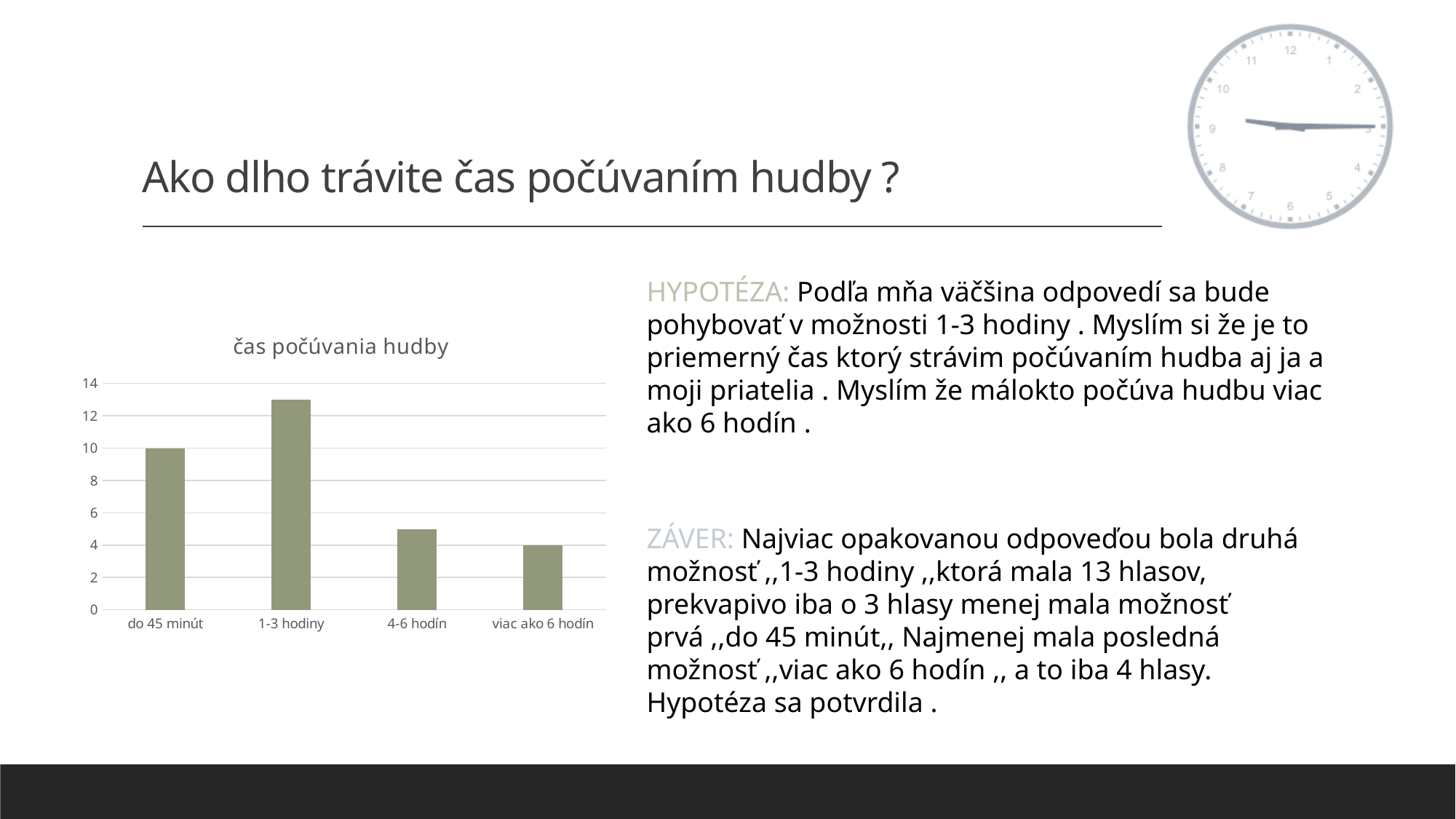
What is the highest value shown on the vertical axis of the chart? 14 Which category has the highest value? 1-3 hodiny What is the value for 'do 45 minút'? 10 What kind of chart is shown on the slide? bar chart Is the value for '4-6 hodín' greater or less than 6? less Which is larger, the value for 'do 45 minút' or the value for '4-6 hodín'? do 45 minút Is the value for '1-3 hodiny' greater or less than 12? greater What is the difference between the value for 'do 45 minút' and the value for 'viac ako 6 hodín'? 6 Which category has the lowest value? viac ako 6 hodín How many categories are shown on the x axis of the chart? 4 What is the title of the chart? čas počúvania hudby What is the value for 'viac ako 6 hodín'? 4